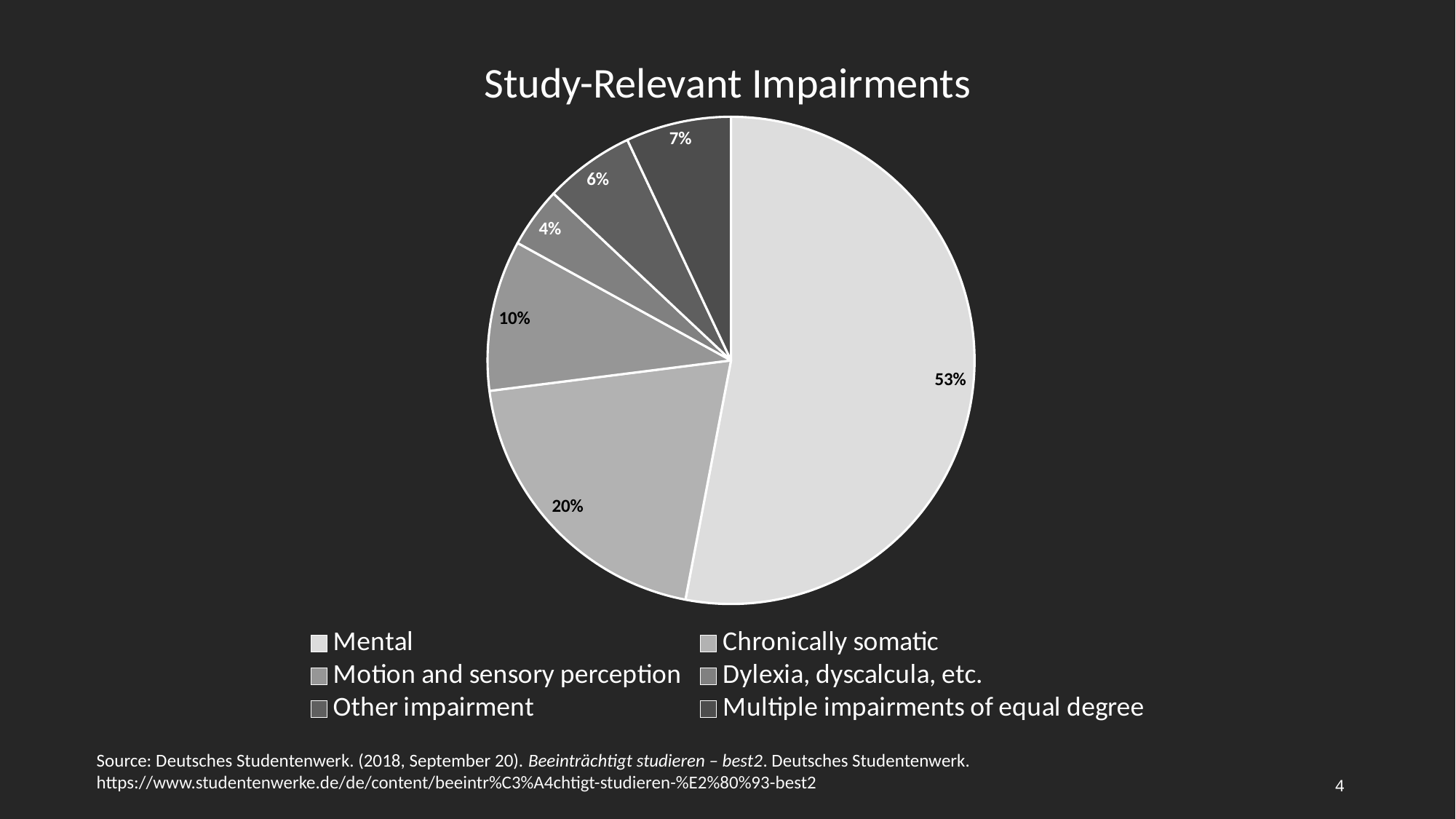
What share of the pie does Mental represent? 53% What share of the pie does Other impairment represent? 6% Which is larger, the slice for Other impairment or the slice for Multiple impairments of equal degree? Multiple impairments of equal degree How many categories does the legend list? 6 What share of the pie does Multiple impairments of equal degree represent? 7% What is the title of the chart? Study-Relevant Impairments What type of chart is shown on the slide? Pie chart What share of the pie does Motion and sensory perception represent? 10% Which category has the largest slice of the pie? Mental What is the difference in percentage points between Mental and Chronically somatic? 33 Which category has the smallest slice of the pie? Dylexia, dyscalcula, etc. What share of the pie does Chronically somatic represent? 20%